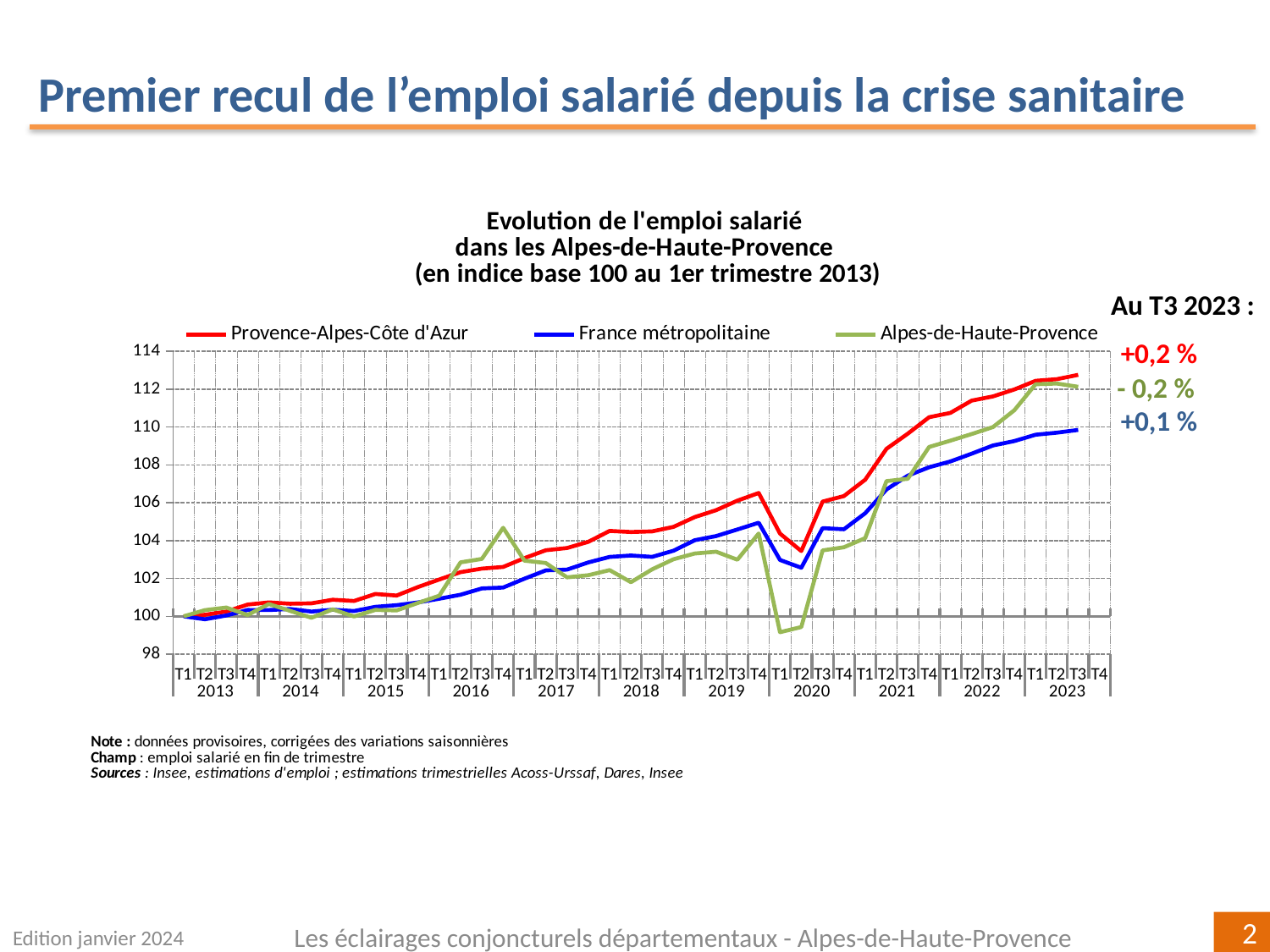
Overall, do the index values rise or fall from 2013 to 2023? Rise Is the value for Alpes-de-Haute-Provence at T1 2020 greater or less than 100? less How many series does the legend list? 3 What is the base value of the index at the 1st quarter of 2013, according to the chart title? 100 Is the value for Provence-Alpes-Côte d'Azur at T3 2023 greater or less than 112? greater What kind of chart is shown on the slide? Line chart At T3 2023, which series is higher: Provence-Alpes-Côte d'Azur or France métropolitaine? Provence-Alpes-Côte d'Azur According to the annotation at T3 2023, what is the change shown in blue for France métropolitaine? +0,1 % According to the annotation at T3 2023, what is the change shown in red for Provence-Alpes-Côte d'Azur? +0,2 % According to the annotation at T3 2023, what is the change shown in green for Alpes-de-Haute-Provence? - 0,2 % Which series is drawn in green in the chart? Alpes-de-Haute-Provence